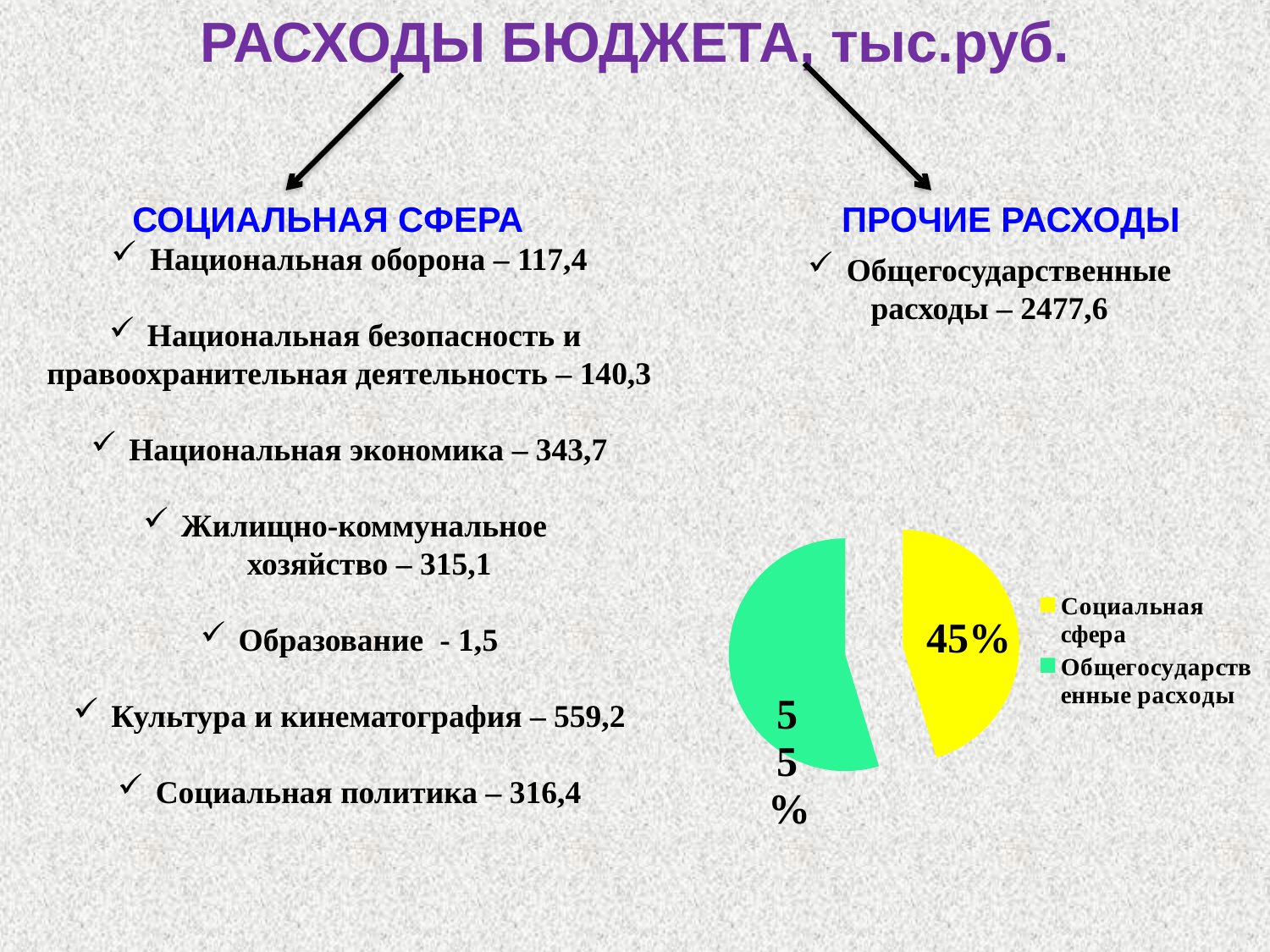
Which slice of the pie chart is the smallest? Социальная сфера Which is larger in the pie chart: "Социальная сфера" or "Общегосударственные расходы"? Общегосударственные расходы How many entries does the legend of the pie chart list? 2 What colour is the "Общегосударственные расходы" slice in the pie chart? green Which slice of the pie chart is the largest? Общегосударственные расходы What share of the pie does the "Социальная сфера" slice represent? 45% What share of the pie does the "Общегосударственные расходы" slice represent? 55% Is the share of "Социальная сфера" in the pie chart greater or less than 50%? less How many slices does the pie chart have? 2 By how many percentage points does the "Общегосударственные расходы" slice exceed the "Социальная сфера" slice? 10 What colour is the "Социальная сфера" slice in the pie chart? yellow What kind of chart is shown on the slide? pie chart